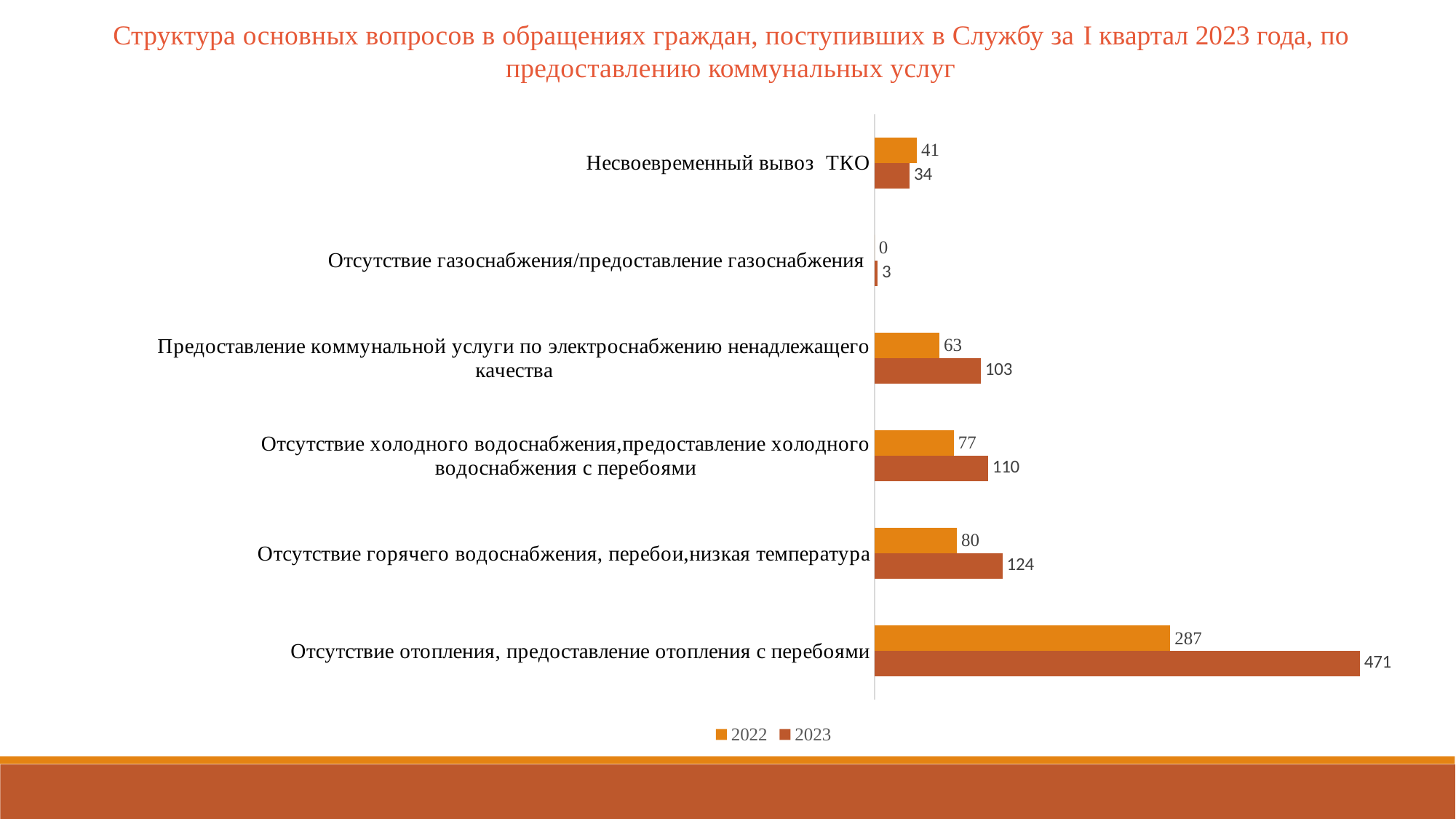
What are the two series listed in the legend? 2022 and 2023 Which category has the highest 2023 value? Отсутствие отопления, предоставление отопления с перебоями How many categories are shown on the chart? 6 What is the difference between the 2023 and 2022 values for "Отсутствие горячего водоснабжения, перебои,низкая температура"? 44 What is the 2023 value for "Отсутствие газоснабжения/предоставление газоснабжения"? 3 What is the difference between the 2023 and 2022 values for "Отсутствие отопления, предоставление отопления с перебоями"? 184 What type of chart is shown on the slide? bar chart Which is larger for "Несвоевременный вывоз ТКО": the 2022 value or the 2023 value? 2022 What is the 2022 value for "Несвоевременный вывоз ТКО"? 41 What is the 2023 value for "Отсутствие отопления, предоставление отопления с перебоями"? 471 Which category has the lowest 2022 value? Отсутствие газоснабжения/предоставление газоснабжения How many series does the legend list? 2